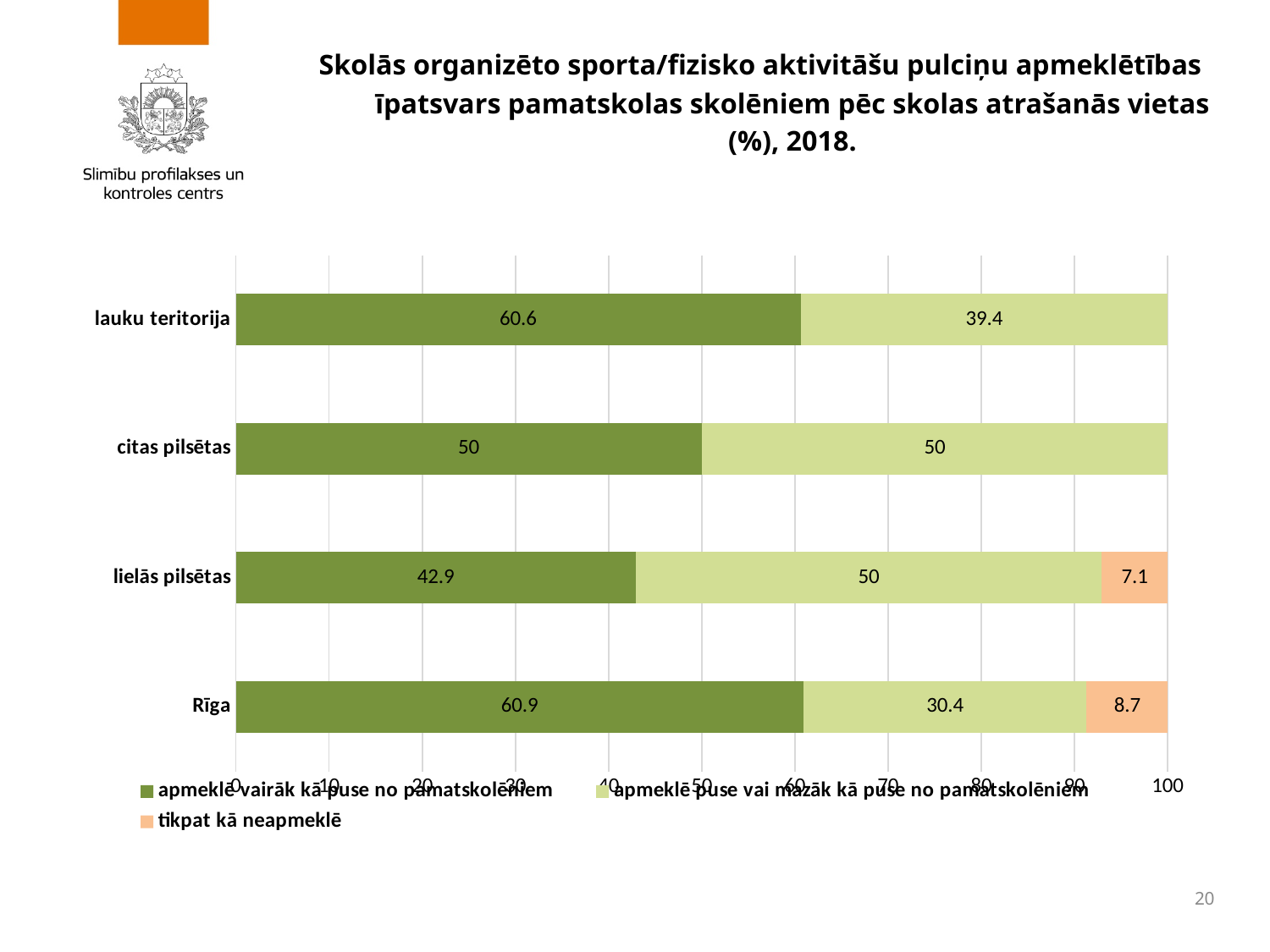
What is the value of "apmeklē vairāk kā puse no pamatskolēniem" for lauku teritorija? 60.6 Is the "apmeklē vairāk kā puse no pamatskolēniem" value for Rīga greater or less than 50? greater What is the difference between the two segments of the lauku teritorija bar (60.6 and 39.4)? 21.2 How many series does the legend list? 3 How many categories are shown on the chart? 4 Which category has the highest value for "tikpat kā neapmeklē"? Rīga What is the total of the stacked bar for lielās pilsētas? 100 What kind of chart is shown on the slide? stacked bar chart Which category has the lowest value for "apmeklē vairāk kā puse no pamatskolēniem"? lielās pilsētas What is the value of "tikpat kā neapmeklē" for Rīga? 8.7 What is the value of "apmeklē puse vai mazāk kā puse no pamatskolēniem" for lielās pilsētas? 50 Which is larger: the "apmeklē puse vai mazāk kā puse no pamatskolēniem" value for lauku teritorija or for Rīga? lauku teritorija